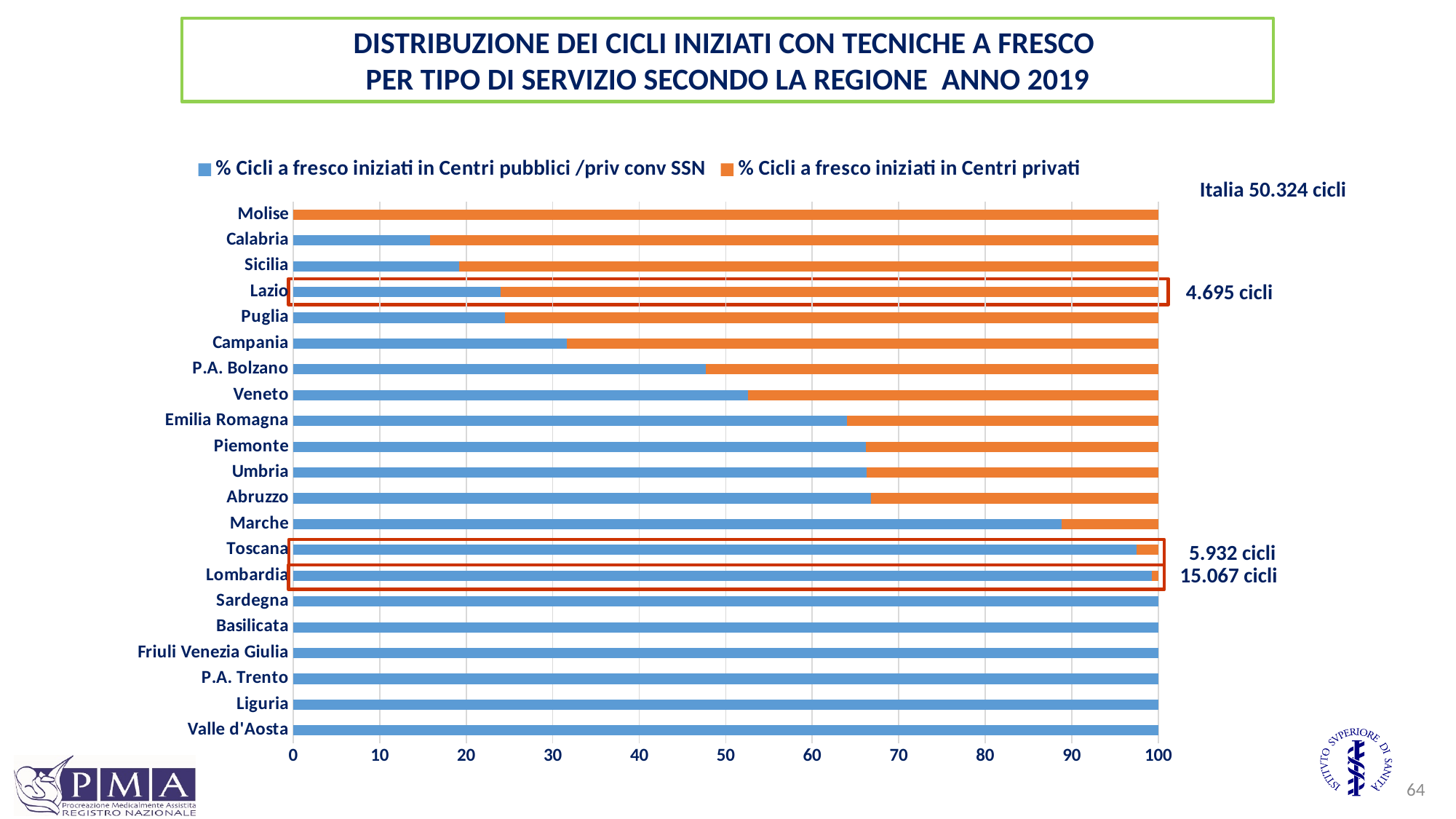
Which region has the lowest share of cycles started in public/SSN-contracted centres (blue)? Molise Which region has a larger share of cycles in public/SSN-contracted centres, Sicilia or Puglia? Puglia Is the percentage of cycles in public/SSN-contracted centres for Calabria greater or less than 20? less Which region has the highest share of cycles started in private centres (orange)? Molise What kind of chart is shown on the slide? bar chart How many regions are plotted on the chart? 21 Is the percentage of cycles in public/SSN-contracted centres for Emilia Romagna greater or less than 60? greater Is the percentage of cycles in public/SSN-contracted centres for Marche greater or less than 80? greater How many cycles are annotated for Lombardia on the slide? 15.067 cicli What is the percentage of fresh cycles started in public/SSN-contracted centres for Valle d'Aosta? 100 How many series does the legend list? 2 Going down the chart from Molise to Valle d'Aosta, do the blue bars get longer or shorter? longer